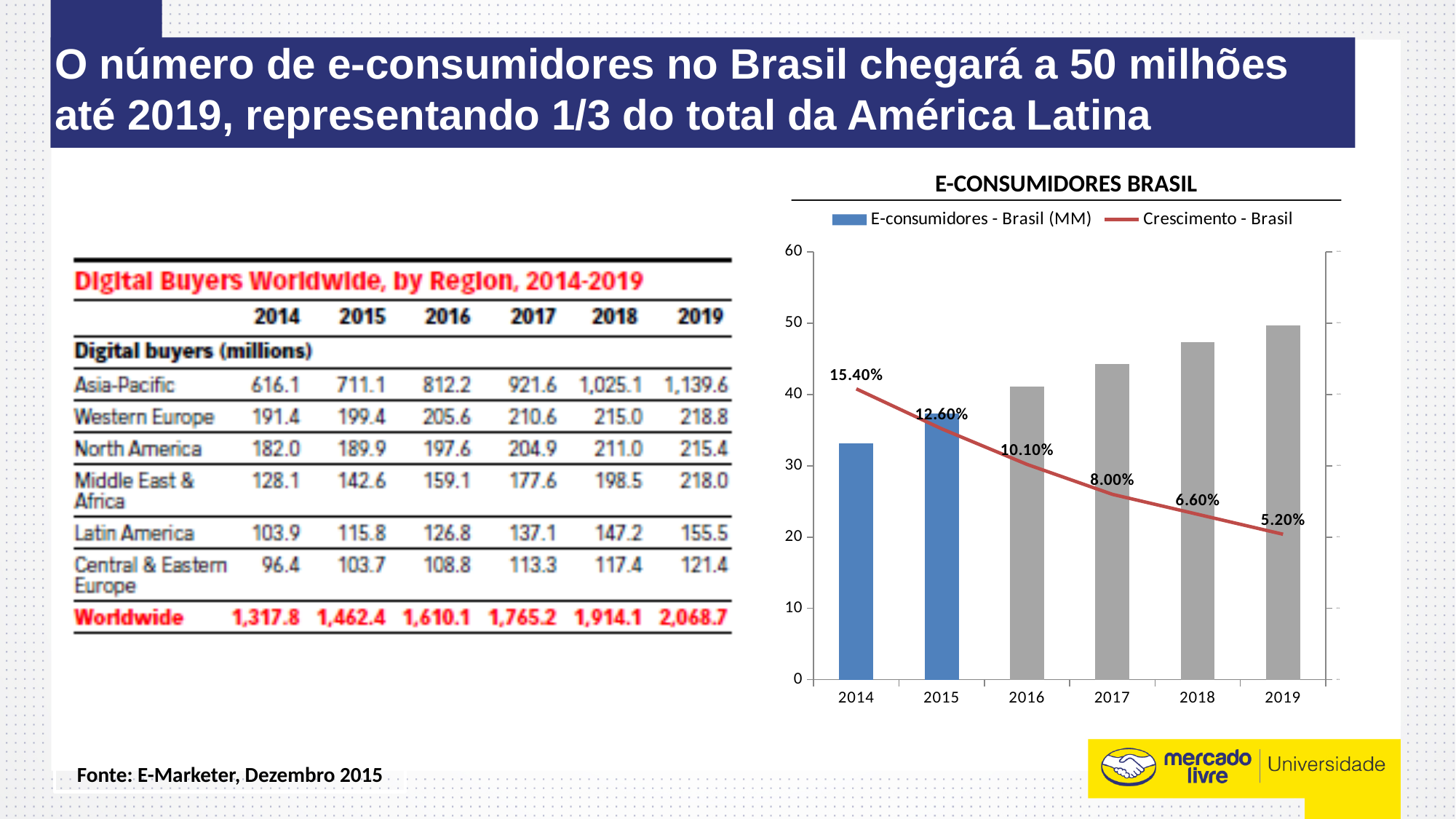
How many years are shown on the x axis of the chart? 6 How many series does the chart legend list? 2 What is the Crescimento - Brasil value for 2014? 15.40% Does the Crescimento - Brasil line rise or fall from 2014 to 2019? Fall In which year is the Crescimento - Brasil value lowest? 2019 In which year is the Crescimento - Brasil value highest? 2014 What type of chart is shown on the slide? Combined bar and line chart Is the E-consumidores - Brasil (MM) value for 2014 greater or less than 30? greater What is the title of the chart on the right of the slide? E-CONSUMIDORES BRASIL What is the Crescimento - Brasil value for 2017? 8.00% What is the Crescimento - Brasil value for 2019? 5.20% What is the difference between the Crescimento - Brasil values for 2015 and 2016? 2.50%